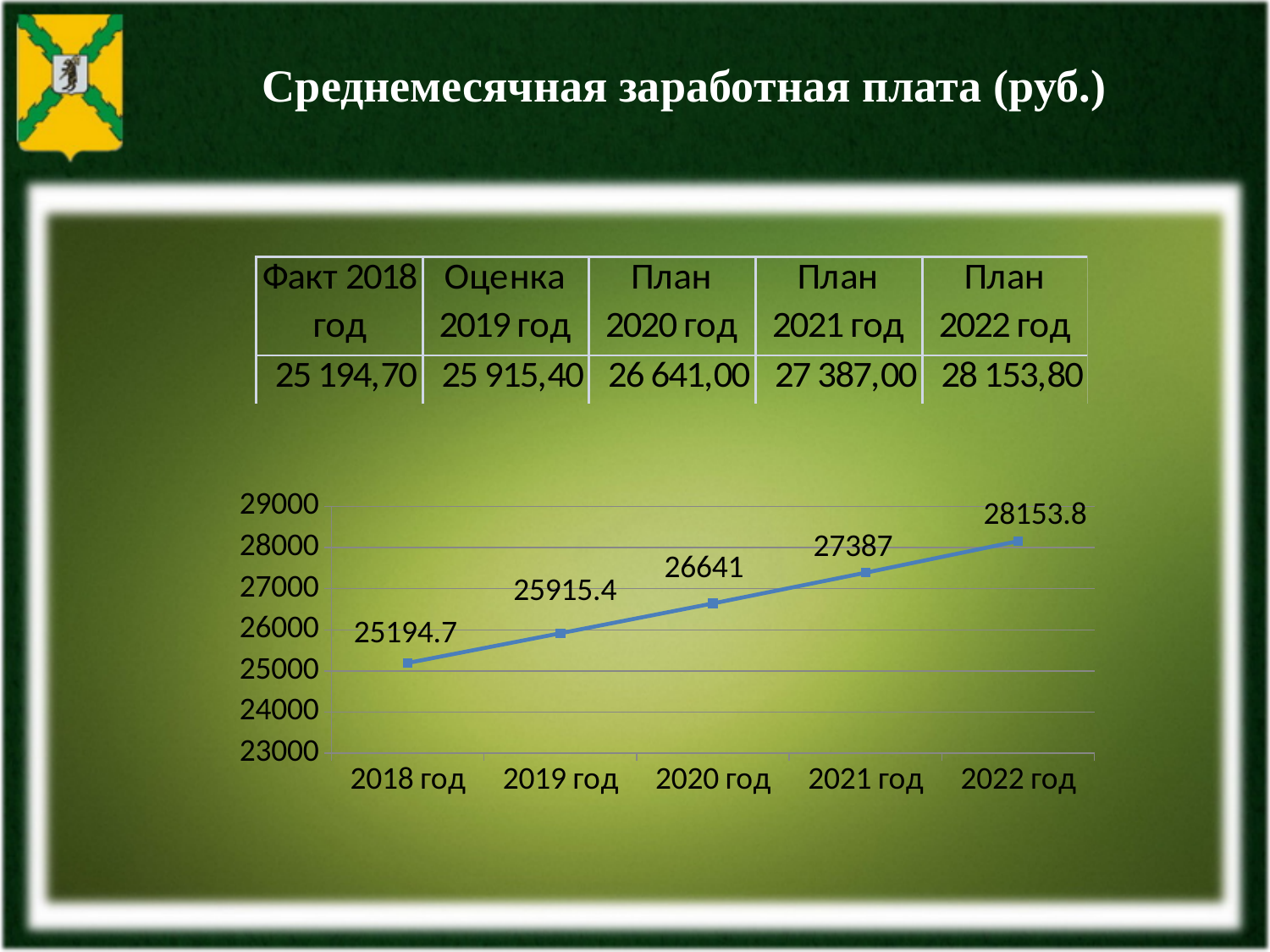
What is the value plotted for 2018 год? 25194.7 Which is larger, the value for 2020 год or the value for 2019 год? 2020 год What is the value plotted for 2019 год? 25915.4 What is the value plotted for 2021 год? 27387 What is the difference between the values for 2021 год and 2020 год? 746 Which year has the highest value on the chart? 2022 год Is the value for 2020 год greater or less than 27000? less Do the values rise or fall from 2018 год to 2022 год? rise Which year has the lowest value on the chart? 2018 год What kind of chart is shown on the slide? line chart What is the difference between the values for 2022 год and 2018 год? 2959.1 How many years are plotted on the x axis of the chart? 5